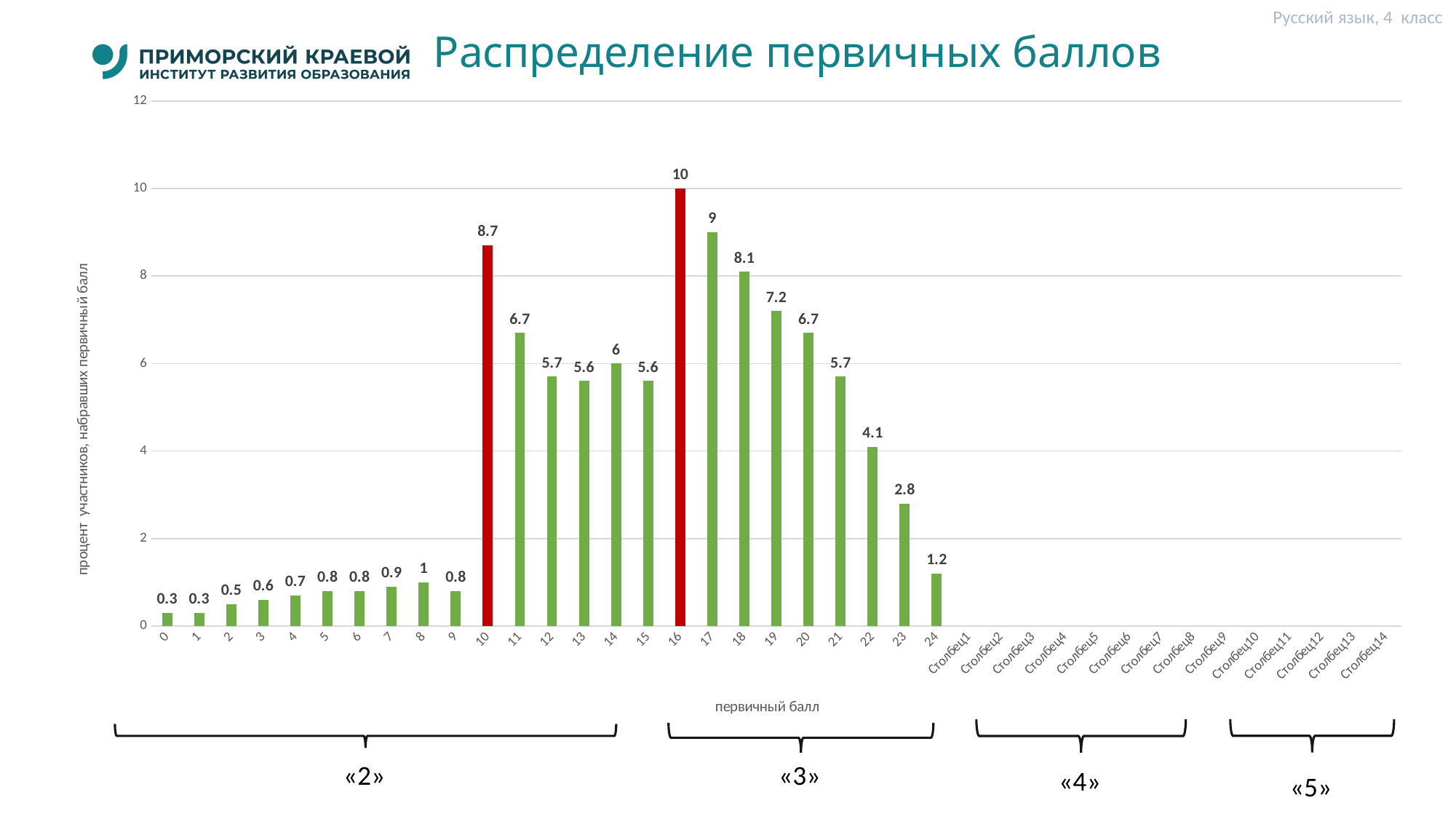
What colour are the bars for primary scores 10 and 16? red Which is larger, the value for primary score 11 or for primary score 12? 11 What is the difference between the values for primary scores 17 and 18? 0.9 What is the value for primary score 16? 10 What is the value for primary score 10? 8.7 What is the value for primary score 22? 4.1 What type of chart is shown on the slide? bar chart Do the values rise or fall from primary score 17 to primary score 24? fall Is the value for primary score 19 greater or less than 6? greater How many bars with data labels are plotted on the chart? 25 Which primary score has the highest percentage of participants? 16 What is the value for primary score 8? 1